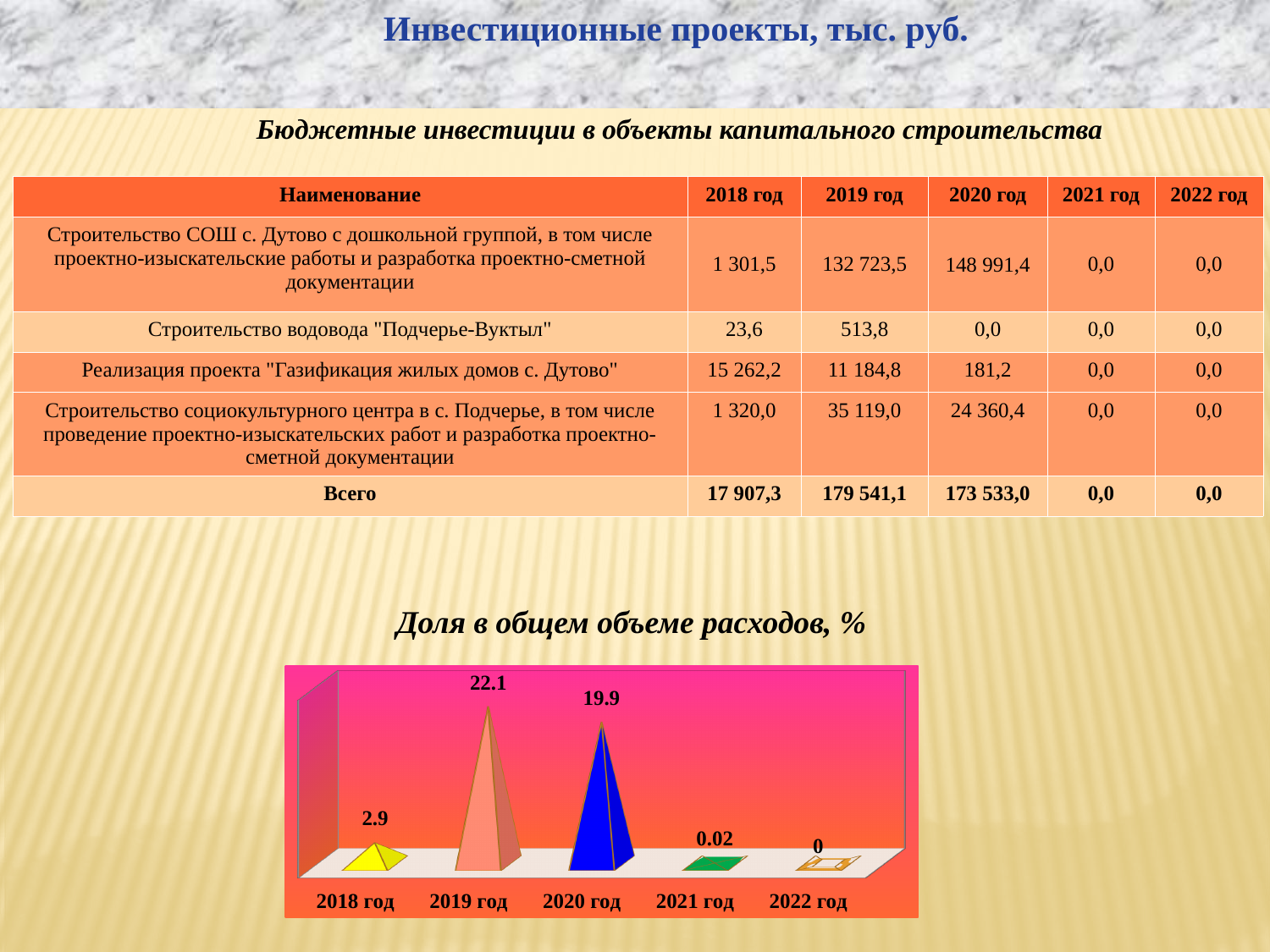
In the chart "Доля в общем объеме расходов, %", which year has the lowest value? 2022 год In the chart "Доля в общем объеме расходов, %", what is the value for 2018 год? 2.9 In the chart "Доля в общем объеме расходов, %", which is larger, the value for 2018 год or the value for 2020 год? 2020 год What kind of chart is "Доля в общем объеме расходов, %"? Bar chart What is the title of the chart at the bottom of the slide? Доля в общем объеме расходов, % In the chart "Доля в общем объеме расходов, %", what is the value for 2022 год? 0 In the chart "Доля в общем объеме расходов, %", which year has the highest value? 2019 год In the chart "Доля в общем объеме расходов, %", what is the value for 2021 год? 0.02 In the chart "Доля в общем объеме расходов, %", what is the value for 2020 год? 19.9 In the chart "Доля в общем объеме расходов, %", what is the value for 2019 год? 22.1 How many years are shown on the x axis of the chart "Доля в общем объеме расходов, %"? 5 In the chart "Доля в общем объеме расходов, %", what is the difference between the values for 2019 год and 2020 год? 2.2